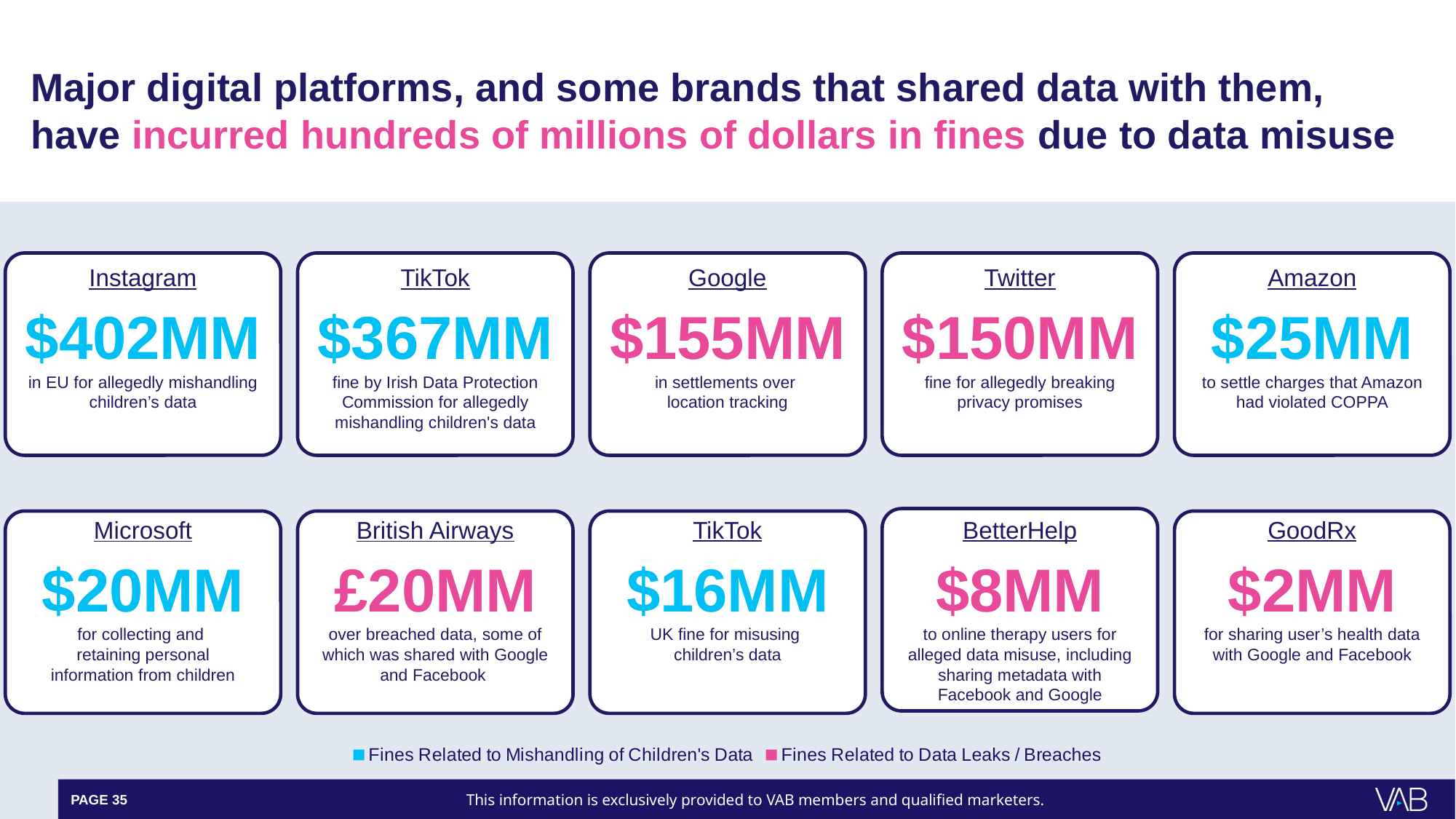
What fine amount is shown for Instagram? $402MM What fine amount is shown for Google? $155MM What is the UK fine amount shown for TikTok for misusing children's data? $16MM Which is larger, the Amazon fine or the Microsoft fine? Amazon How many fine boxes are shown on the slide? 10 How many categories of fines does the legend list? 2 What is the difference between the Google fine and the Twitter fine? $5MM What is the difference between the Instagram fine and the TikTok Irish Data Protection Commission fine? $35MM Which company has the smallest fine shown on the slide? GoodRx Which company has the largest fine shown on the slide? Instagram What fine amount is shown for BetterHelp? $8MM According to the legend, what category do the pink-coloured fine amounts represent? Fines Related to Data Leaks / Breaches